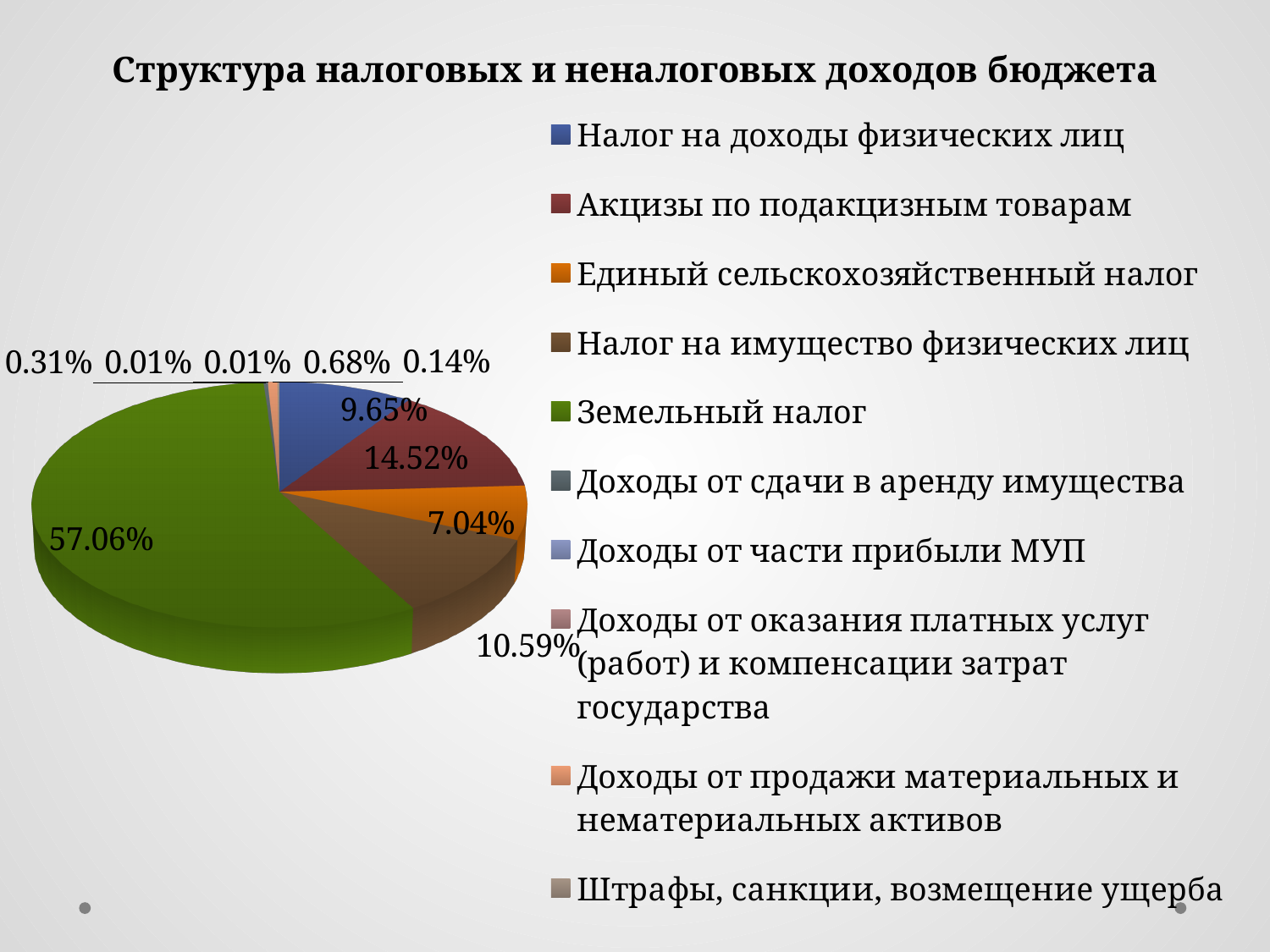
What is the title of the chart? Структура налоговых и неналоговых доходов бюджета Which category has the largest share of the pie? Земельный налог What share does Налог на имущество физических лиц have? 10.59% What share does Акцизы по подакцизным товарам have? 14.52% What colour is the slice for Земельный налог? Green How many categories does the legend list? 10 Which is larger: the share of Акцизы по подакцизным товарам or the share of Налог на имущество физических лиц? Акцизы по подакцизным товарам What share does Земельный налог have? 57.06% What is the difference between the shares of Акцизы по подакцизным товарам and Налог на доходы физических лиц? 4.87% What type of chart is shown on the slide? Pie chart What share does Единый сельскохозяйственный налог have? 7.04% What share does Налог на доходы физических лиц have? 9.65%